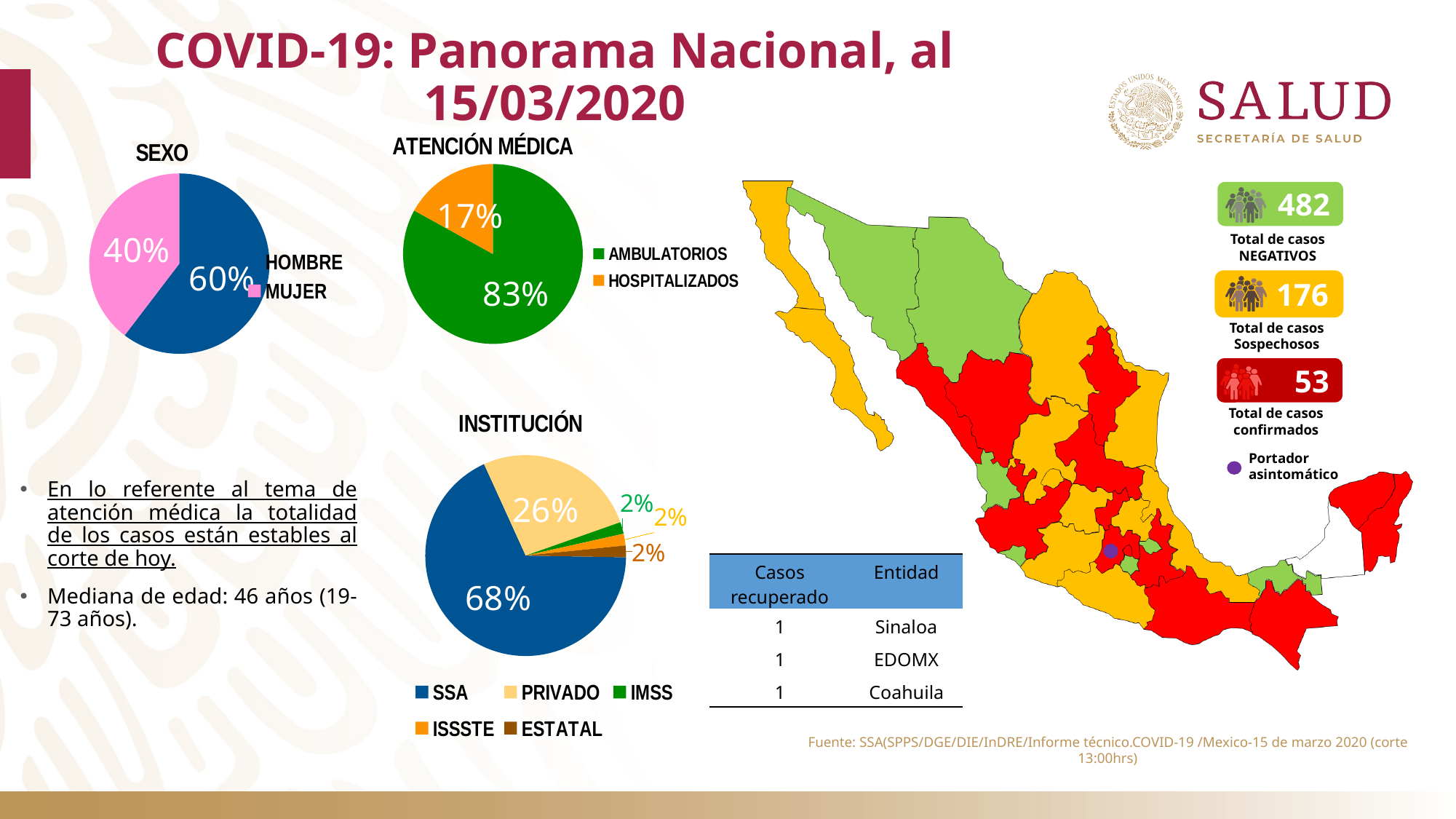
In the SEXO pie chart, what is the difference in percentage points between HOMBRE and MUJER? 20 In the INSTITUCIÓN pie chart, what share is labelled for PRIVADO? 26% In the SEXO pie chart, which category has the larger share? HOMBRE In the SEXO pie chart, what share is labelled for MUJER? 40% In the ATENCIÓN MÉDICA pie chart, which category has the smaller share? HOSPITALIZADOS In the ATENCIÓN MÉDICA pie chart, what share is labelled for HOSPITALIZADOS? 17% In the ATENCIÓN MÉDICA pie chart, what share is labelled for AMBULATORIOS? 83% In the INSTITUCIÓN pie chart, how many categories does the legend list? 5 In the INSTITUCIÓN pie chart, what share is labelled for SSA? 68% In the INSTITUCIÓN pie chart, which category has the largest share? SSA In the SEXO pie chart, what share is labelled for HOMBRE? 60% What kind of chart is the ATENCIÓN MÉDICA chart? Pie chart